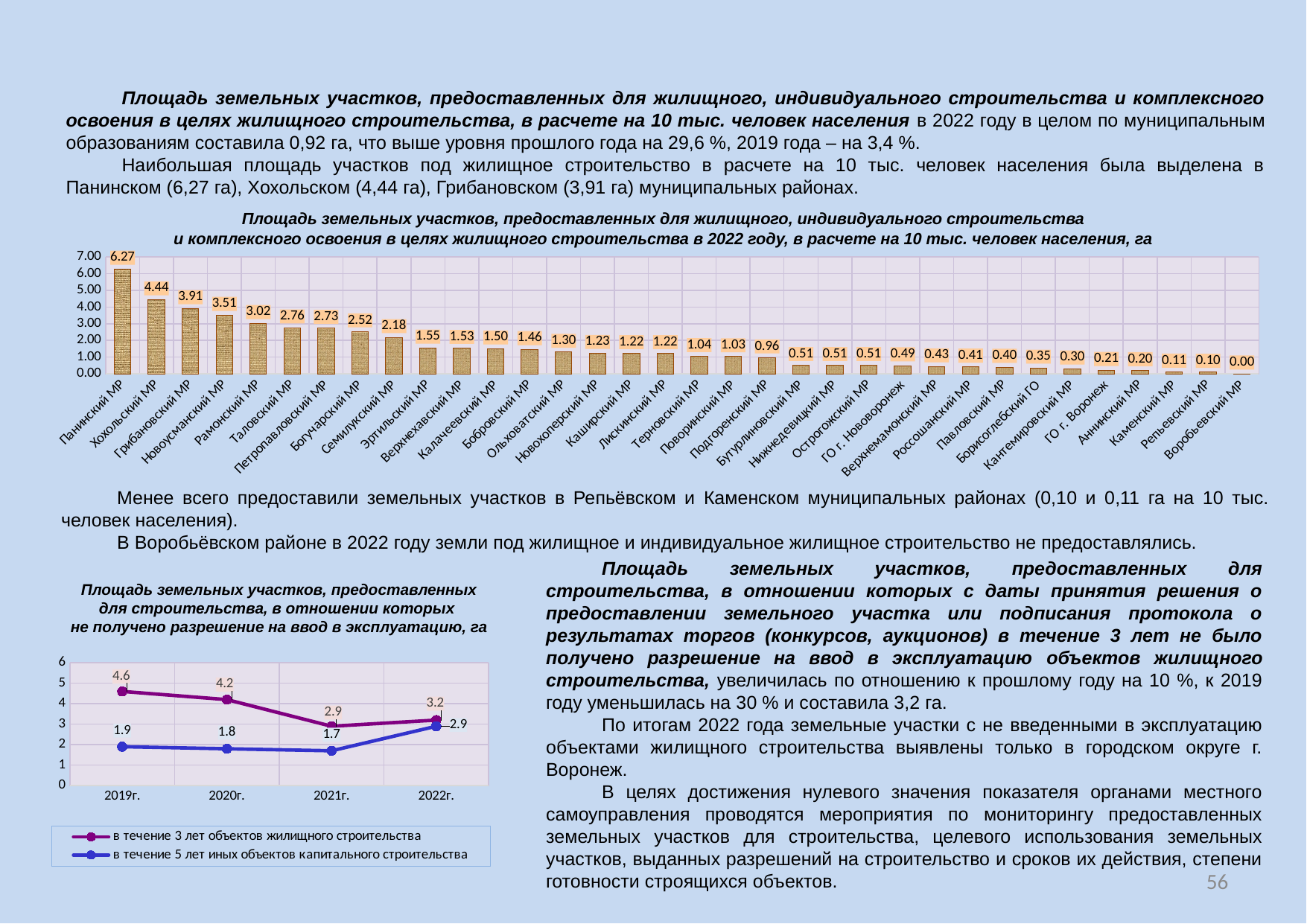
In the top bar chart, what is the difference between the values for Хохольский МР and Грибановский МР? 0.53 In the top bar chart, what is the value for Семилукский МР? 2.18 How many categories are shown in the top bar chart? 34 How many series does the legend of the bottom line chart list? 2 In the top bar chart, which is larger: the value for Рамонский МР or the value for Таловский МР? Рамонский МР In the bottom line chart, does the series 'в течение 3 лет объектов жилищного строительства' rise or fall from 2019г. to 2021г.? Fall What kind of chart is the top chart on the slide? Bar chart In the bottom line chart, what is the value for 2019г. for the series 'в течение 3 лет объектов жилищного строительства'? 4.6 In the bottom line chart, what is the value for 2022г. for the series 'в течение 5 лет иных объектов капитального строительства'? 2.9 In the top bar chart, which category has the lowest value? Воробьевский МР In the top bar chart, what is the value for Панинский МР? 6.27 In the top bar chart, which category has the highest value? Панинский МР